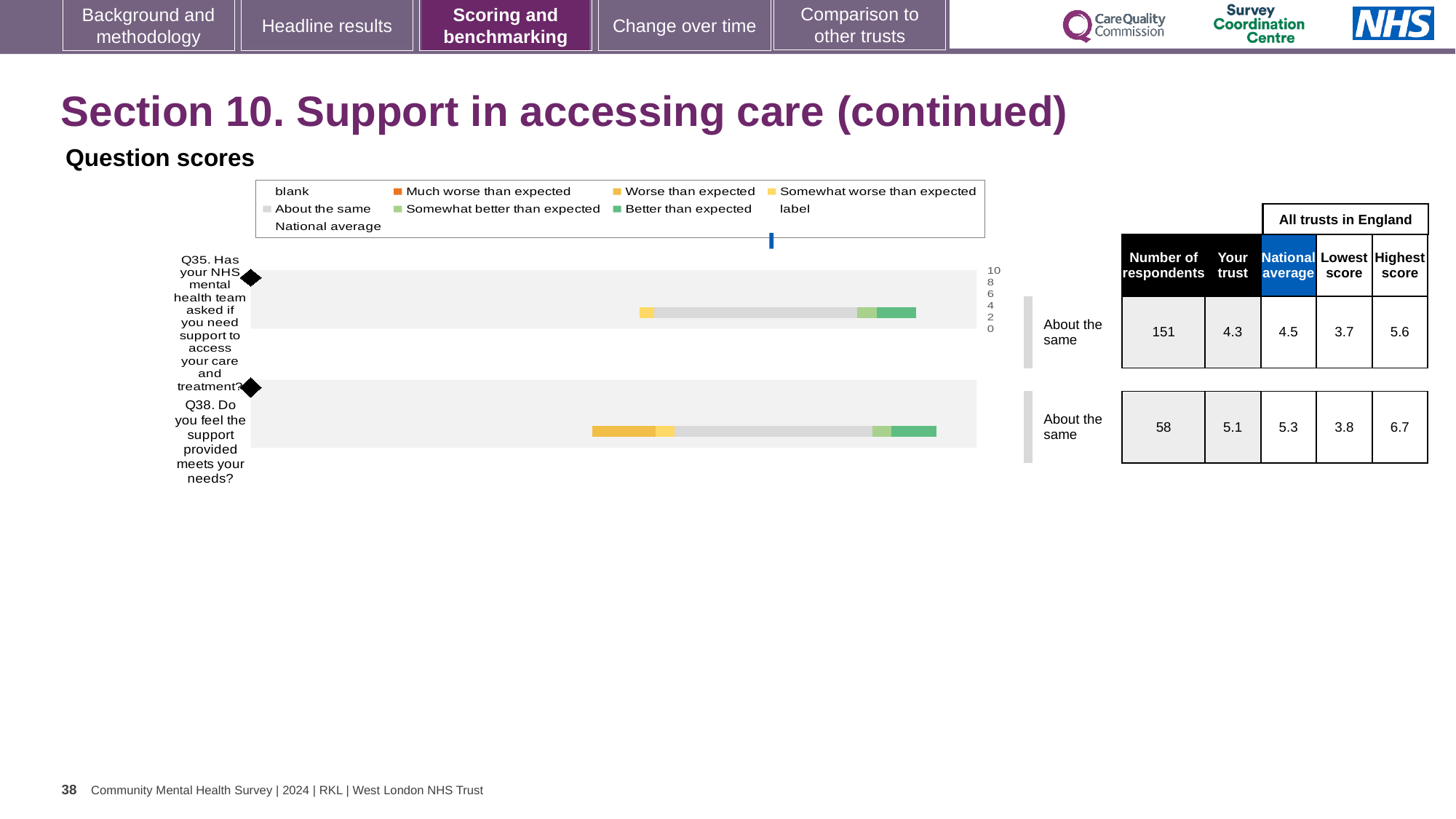
What benchmark category is shown for Q35 and Q38 in the chart? About the same What is the difference between the highest and lowest scores for Q38? 2.9 Is the 'Your trust' score for Q38 higher or lower than the national average for Q38? lower How many questions are plotted in the question scores chart? 2 What kind of chart is used to show the question scores on this slide? bar chart What is the 'Your trust' score for Q35? 4.3 Which question has more respondents, Q35 or Q38? Q35 What is the lowest score among all trusts in England for Q35? 3.7 What is the number of respondents for Q35 in the table next to the chart? 151 What is the highest score among all trusts in England for Q38? 6.7 What is the national average score for Q38? 5.3 What is the number of respondents for Q38 in the table next to the chart? 58